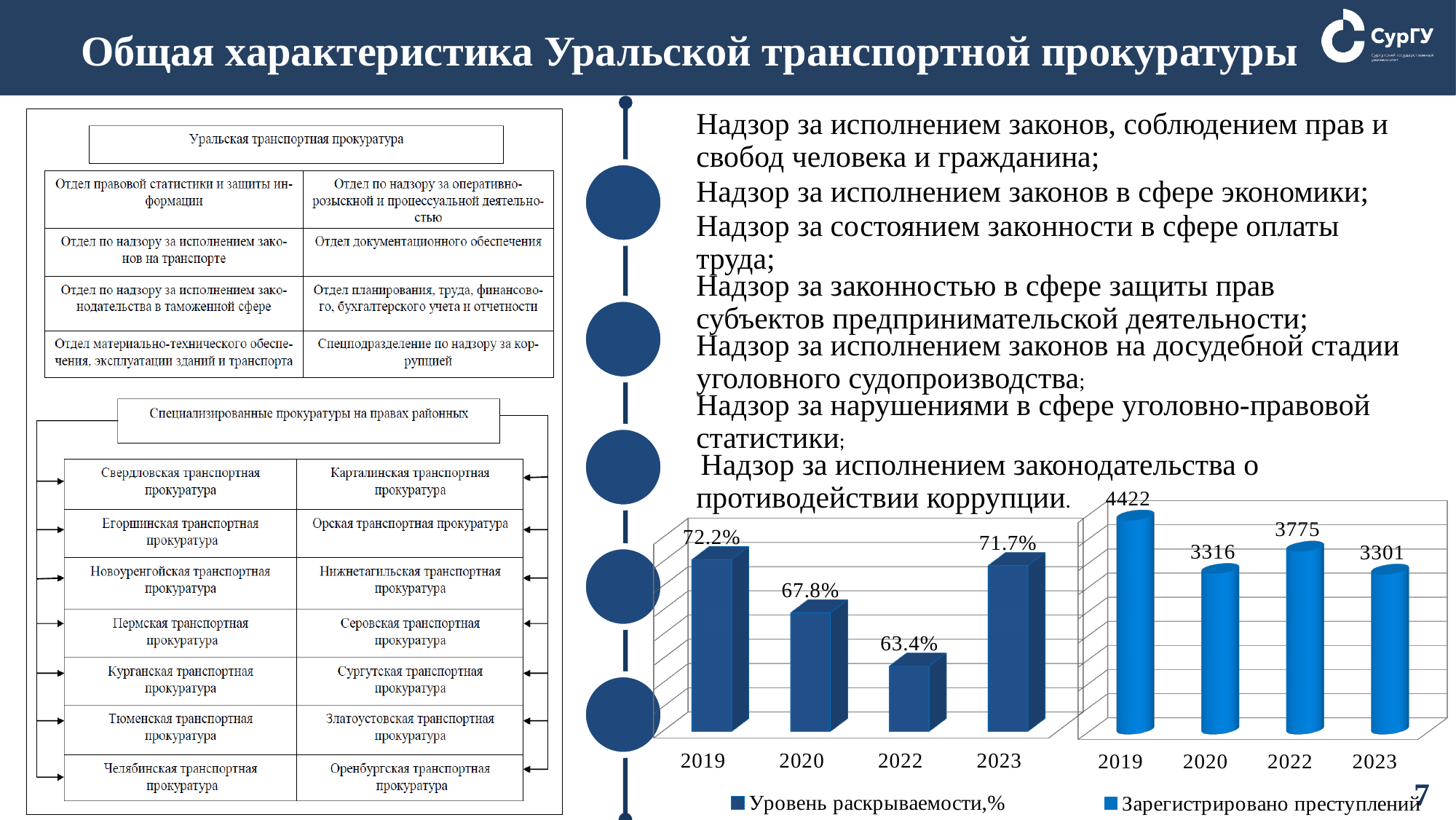
In the left chart (Уровень раскрываемости,%), what is the difference between the values for 2019 and 2023? 0.5% How many years are shown on the x axis of the left chart (Уровень раскрываемости,%)? 4 In the left chart (Уровень раскрываемости,%), which year has the lowest value? 2022 In the right chart (Зарегистрировано преступлений), what is the difference between the values for 2019 and 2020? 1106 What kind of chart is the right chart (Зарегистрировано преступлений)? bar chart In the right chart (Зарегистрировано преступлений), which year has the lowest value? 2023 In the right chart (Зарегистрировано преступлений), which is larger, the value for 2020 or the value for 2022? 2022 In the left chart (Уровень раскрываемости,%), what is the value for 2022? 63.4% In the right chart (Зарегистрировано преступлений), what is the value for 2023? 3301 In the right chart (Зарегистрировано преступлений), what is the value for 2019? 4422 In the left chart (Уровень раскрываемости,%), what is the value for 2019? 72.2% In the right chart (Зарегистрировано преступлений), which year has the highest value? 2019